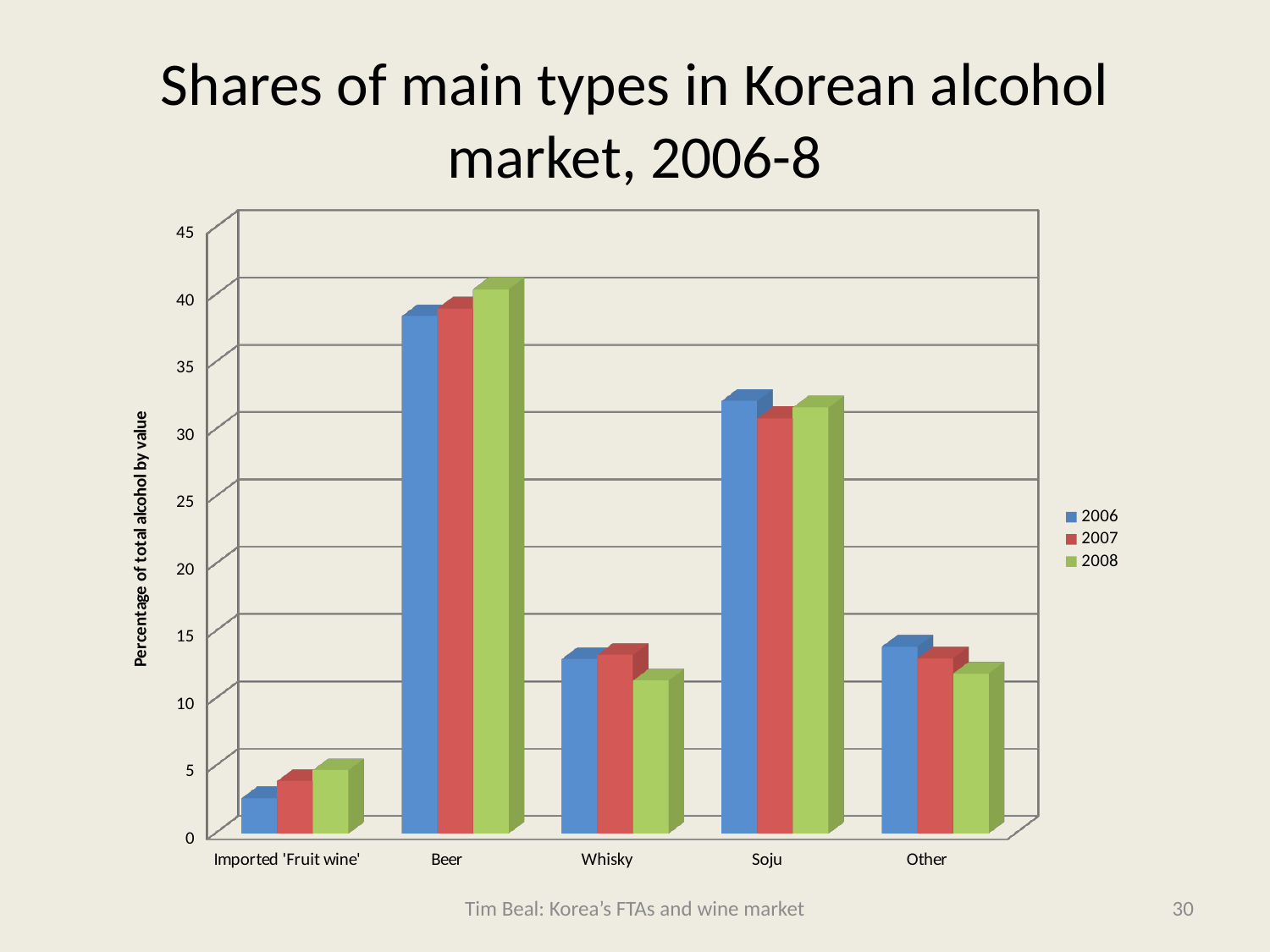
Do the values for Other rise or fall from 2006 to 2008? fall What is the label on the vertical axis? Percentage of total alcohol by value How many series does the legend list? 3 Which category has the highest share in 2008? Beer Which category has the lowest share in 2006? Imported 'Fruit wine' Is the value for Beer in 2008 greater or less than 35? greater Is the value for Soju in 2007 greater or less than 25? greater Is the value for Imported 'Fruit wine' in 2006 greater or less than 5? less Which is larger, the 2006 value for Beer or the 2006 value for Soju? Beer Do the values for Beer rise or fall from 2006 to 2008? rise How many categories are shown on the x axis? 5 What kind of chart is shown on the slide? bar chart